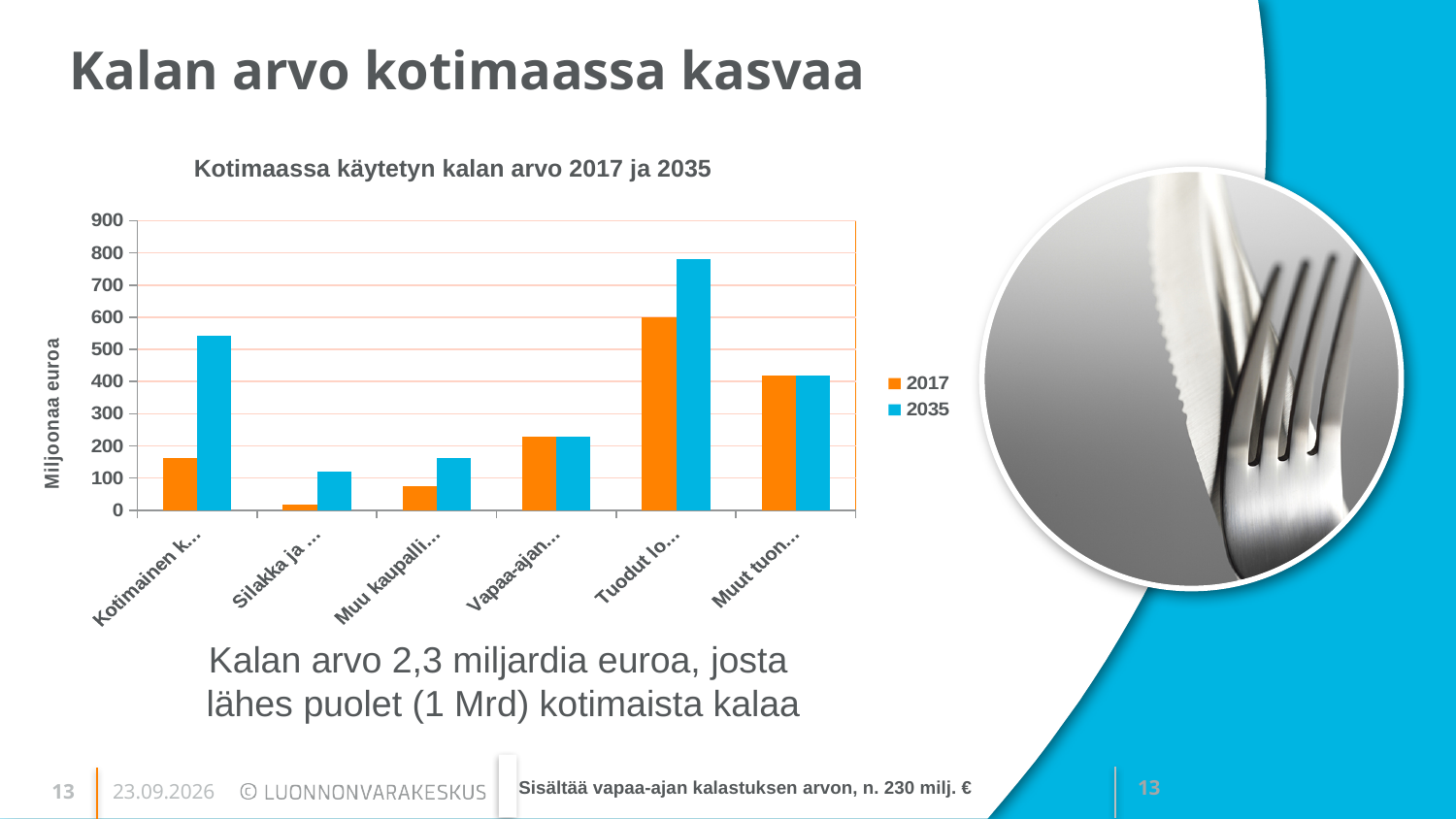
What is the label of the vertical axis of the chart? Miljoonaa euroa Is the 2035 value for 'Silakka ja …' greater or less than 200? less Is the 2017 value for 'Muut tuon…' greater or less than 500? less Is the 2035 value for 'Tuodut lo…' greater or less than 700? greater Which category has the lowest value for the 2017 series? Silakka ja … How many series does the legend of the chart list? 2 Which category has the highest value for the 2017 series? Tuodut lo… Which category has the highest value for the 2035 series? Tuodut lo… How many categories are shown on the x axis of the chart? 6 What kind of chart is shown on the slide? Bar chart For the category 'Kotimainen k…', which series has the larger value, 2017 or 2035? 2035